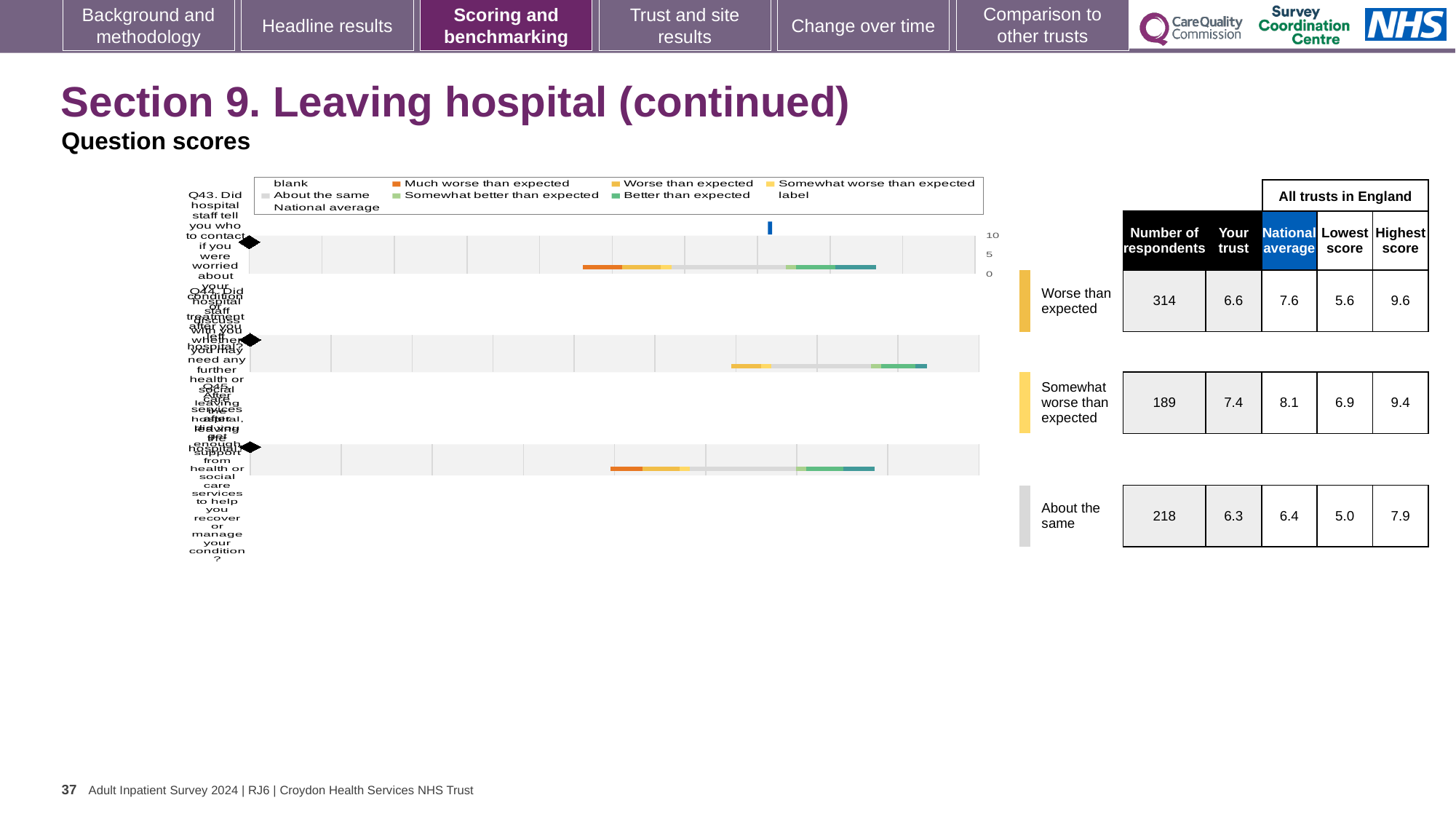
How many respondents are listed for the second question row (rated 'Somewhat worse than expected')? 189 What is the highest score among all trusts in England for the third question row (rated 'About the same')? 7.9 For the first question row (Q43), is the 'Your trust' score higher or lower than the national average? lower How many questions (rows) are plotted in the question scores chart? 3 Which question row has the highest 'Your trust' score? the second row (Somewhat worse than expected), 7.4 For the second question row, what is the difference between the highest score and the lowest score among all trusts in England? 2.5 What is the national average score for the first question row (Q43)? 7.6 For the first question row (Q43), how much higher is the national average than the 'Your trust' score? 1.0 What benchmark category is the first question row (Q43) rated as? Worse than expected Which question row has the lowest 'Your trust' score? the third row (About the same), 6.3 What kind of chart is used to show the question scores on this slide? bar chart What is the 'Your trust' score for the first question row (Q43, about who to contact if worried after leaving hospital)? 6.6